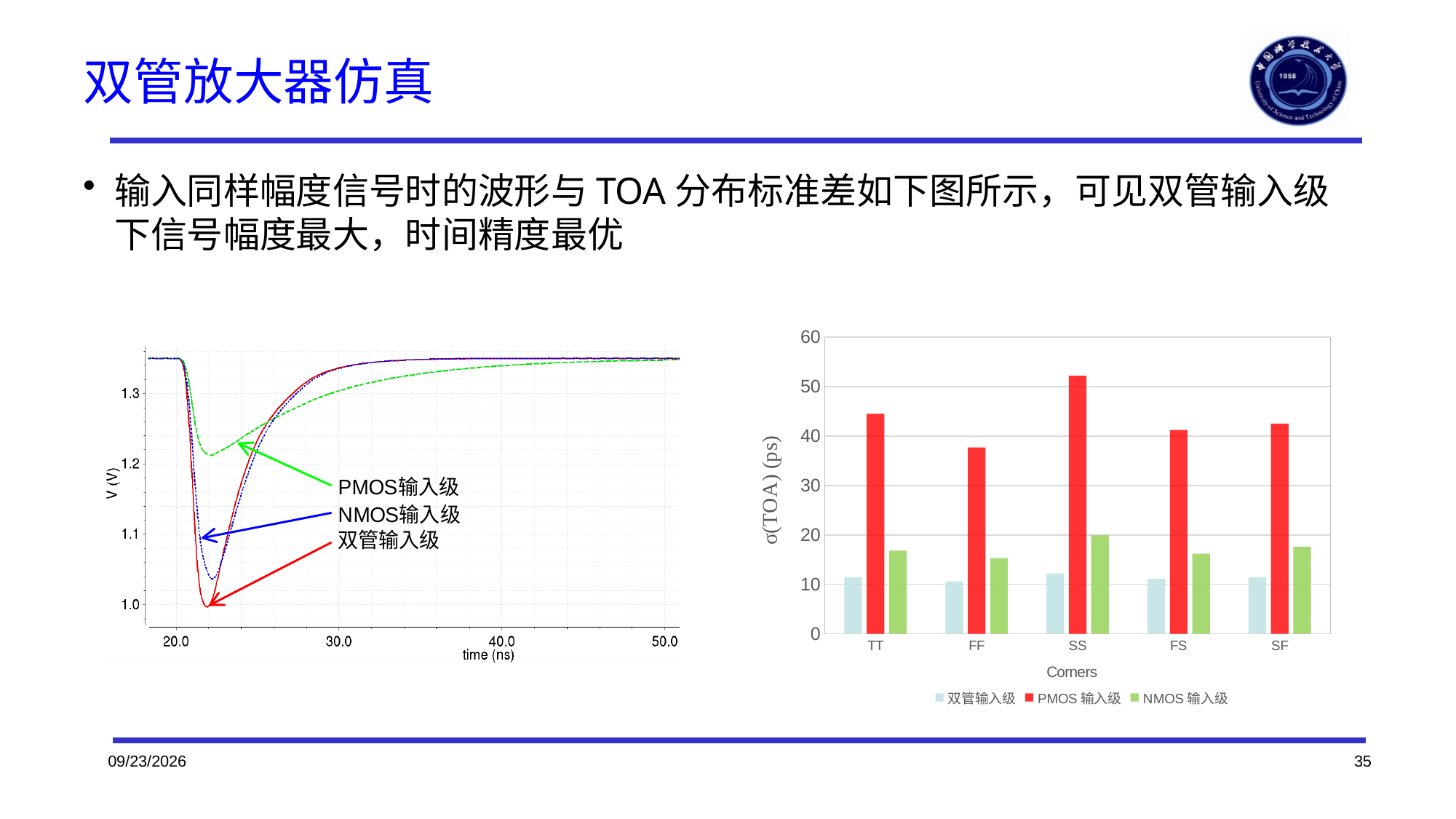
In the bar chart on the right, how many series does the legend list? 3 In the bar chart on the right, is the PMOS 输入级 value at FF greater or less than 40? less In the line chart on the left, which curve reaches the lowest voltage? 双管输入级 In the bar chart on the right, at which corner is the PMOS 输入级 value highest? SS In the bar chart on the right, is the NMOS 输入级 value at TT greater or less than 20? less What kind of chart is the chart on the right of the slide? bar chart In the bar chart on the right, is the PMOS 输入级 value at SS greater or less than 50? greater In the bar chart on the right, which series is larger at FS: 双管输入级 or NMOS 输入级? NMOS 输入级 In the bar chart on the right, how many corners are shown on the x axis? 5 In the bar chart on the right, at which corner is the PMOS 输入级 value lowest? FF What kind of chart is the chart on the left of the slide? line chart In the bar chart on the right, at which corner is the NMOS 输入级 value highest? SS